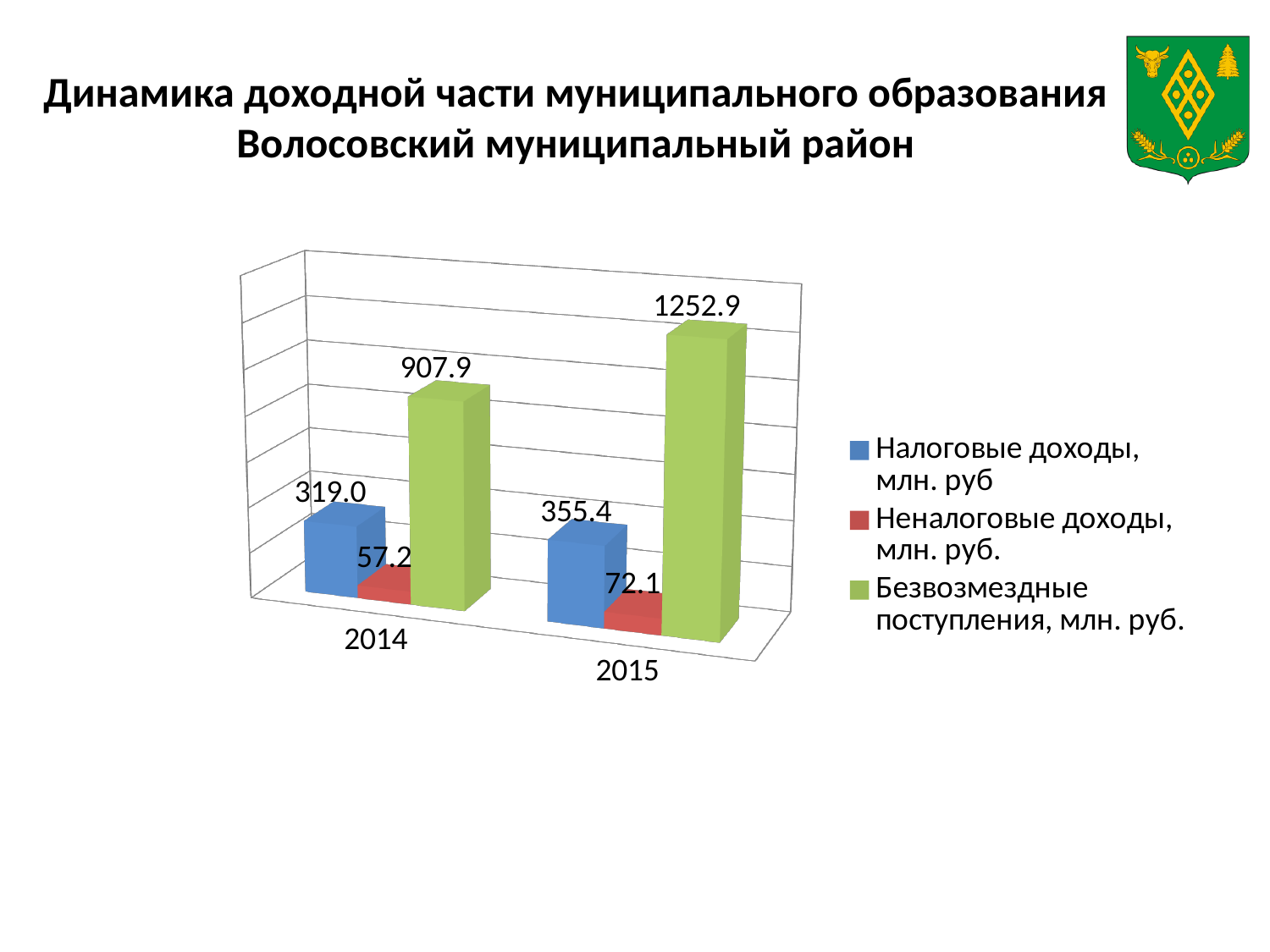
What is the difference between Налоговые доходы in 2015 and in 2014? 36.4 Which series has the lowest value in 2014? Неналоговые доходы, млн. руб. What is the value of Безвозмездные поступления, млн. руб. for 2015? 1252.9 What is the value of Налоговые доходы, млн. руб for 2015? 355.4 How many years are shown on the x axis? 2 What is the difference between Безвозмездные поступления in 2015 and in 2014? 345.0 What is the value of Неналоговые доходы, млн. руб. for 2014? 57.2 Which series has the highest value in 2015? Безвозмездные поступления, млн. руб. What is the value of Налоговые доходы, млн. руб for 2014? 319.0 What kind of chart is shown on the slide? Bar chart How many series does the legend list? 3 Which is larger: Неналоговые доходы in 2014 or in 2015? 2015